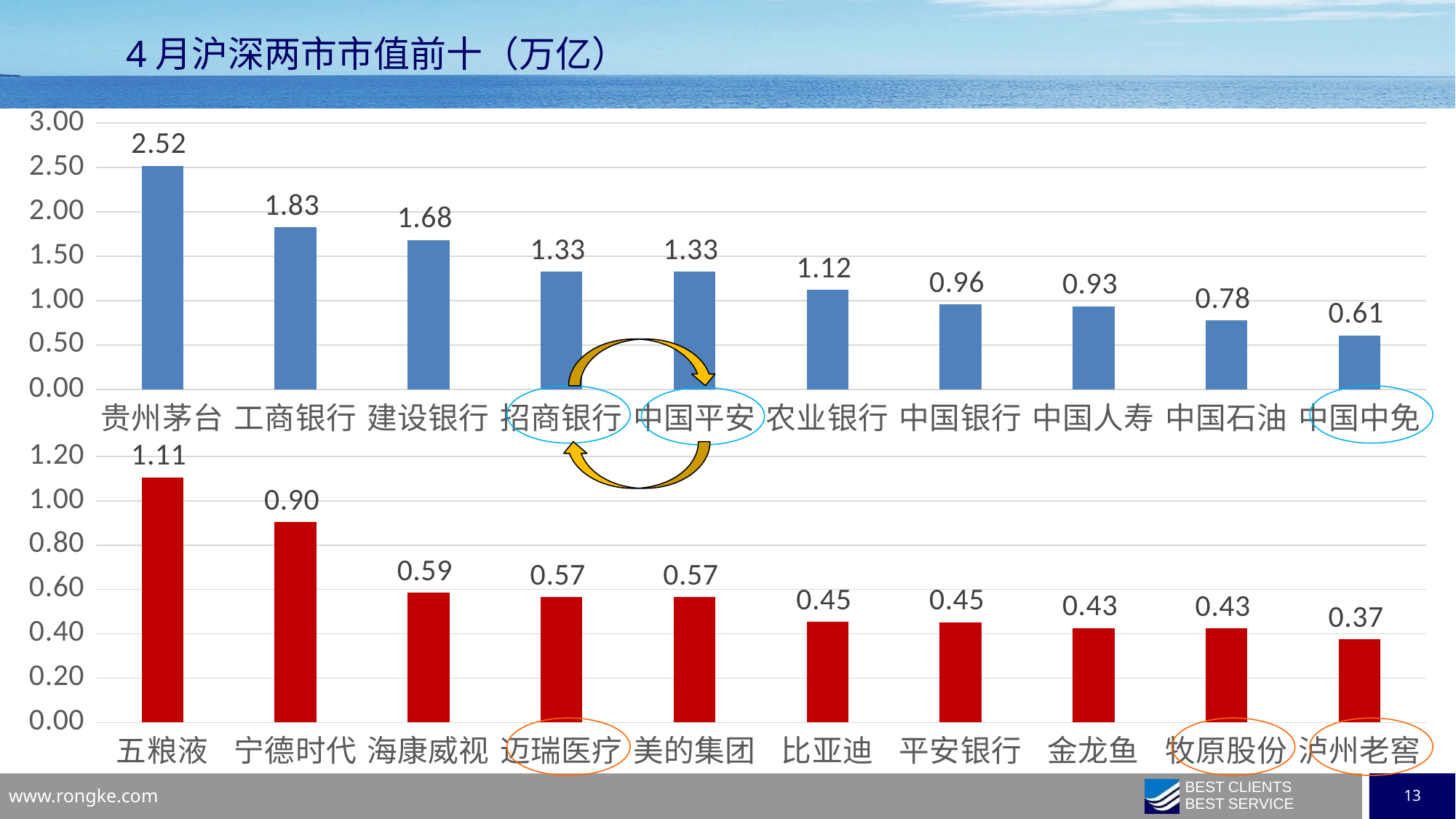
In the top (blue) chart, what is the difference between the values for 工商银行 and 建设银行? 0.15 In the bottom (red) chart, what is the value for 泸州老窖? 0.37 In the top (blue) chart, do the values rise or fall from left to right? fall In the bottom (red) chart, which is larger, the value for 五粮液 or the value for 海康威视? 五粮液 In the top (blue) chart, what is the value for 农业银行? 1.12 What is the title of the slide? 4月沪深两市市值前十（万亿） In the bottom (red) chart, which category has the lowest value? 泸州老窖 How many categories are shown in the bottom (red) chart? 10 In the top (blue) chart, what is the value for 贵州茅台? 2.52 In the top (blue) chart, which category has the highest value? 贵州茅台 In the bottom (red) chart, what is the value for 宁德时代? 0.90 What kind of chart is the top chart on the slide? bar chart